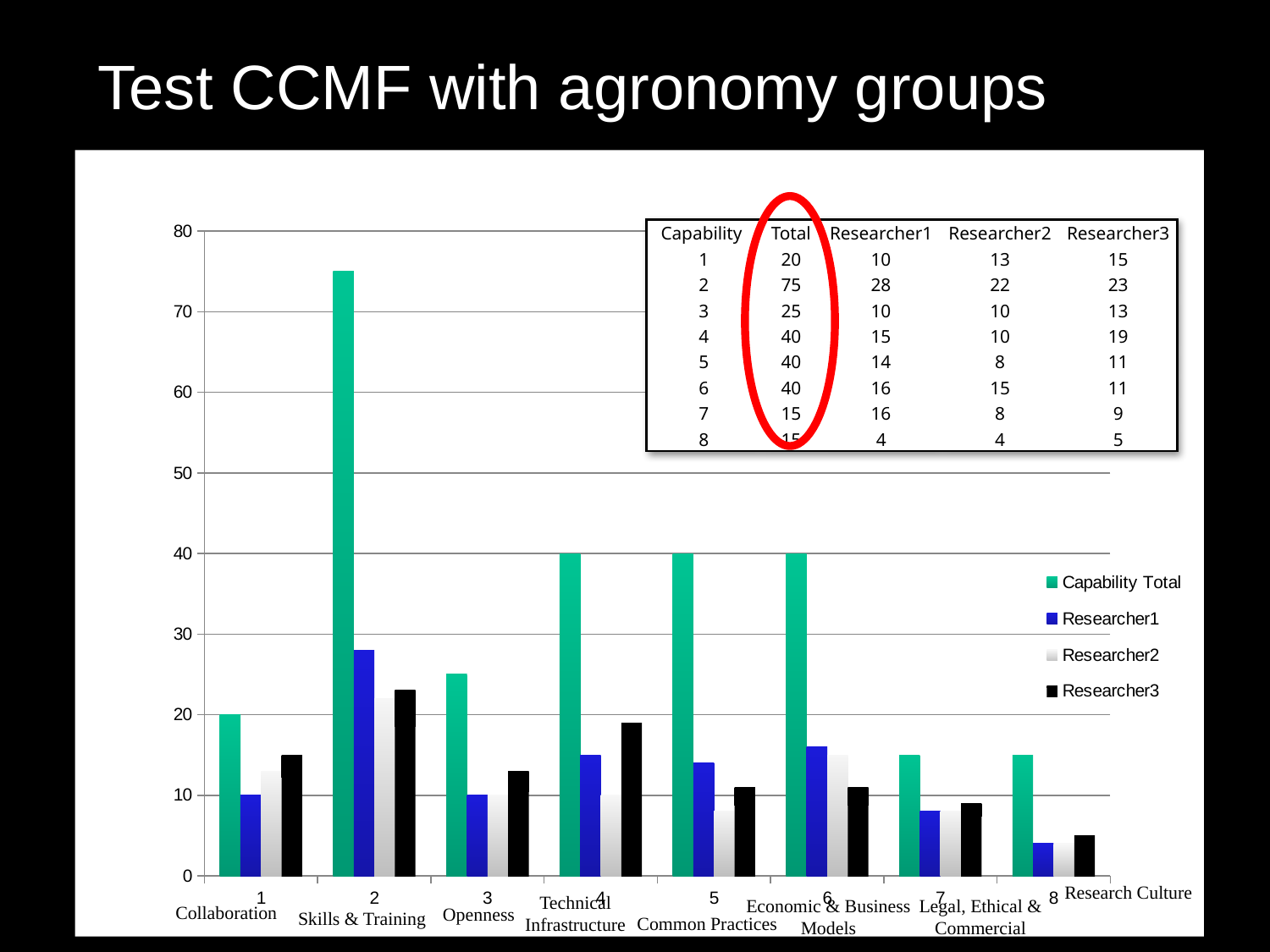
How many capability categories are plotted along the x axis? 8 What is the Researcher1 value for capability 8? 4 Is the Capability Total for capability 2 greater or less than 70? greater Which capability has the highest Capability Total? 2 (Skills & Training) What is the Researcher3 value for capability 4? 19 What is the Researcher1 value for capability 2? 28 What is the Capability Total for capability 2? 75 How many series does the chart legend list? 4 What kind of chart is shown on the slide? bar chart Which series is shown in green in the legend? Capability Total What is the difference between the Capability Total for capability 2 and capability 3? 50 Which is larger for capability 1: the Researcher2 value or the Researcher3 value? Researcher3